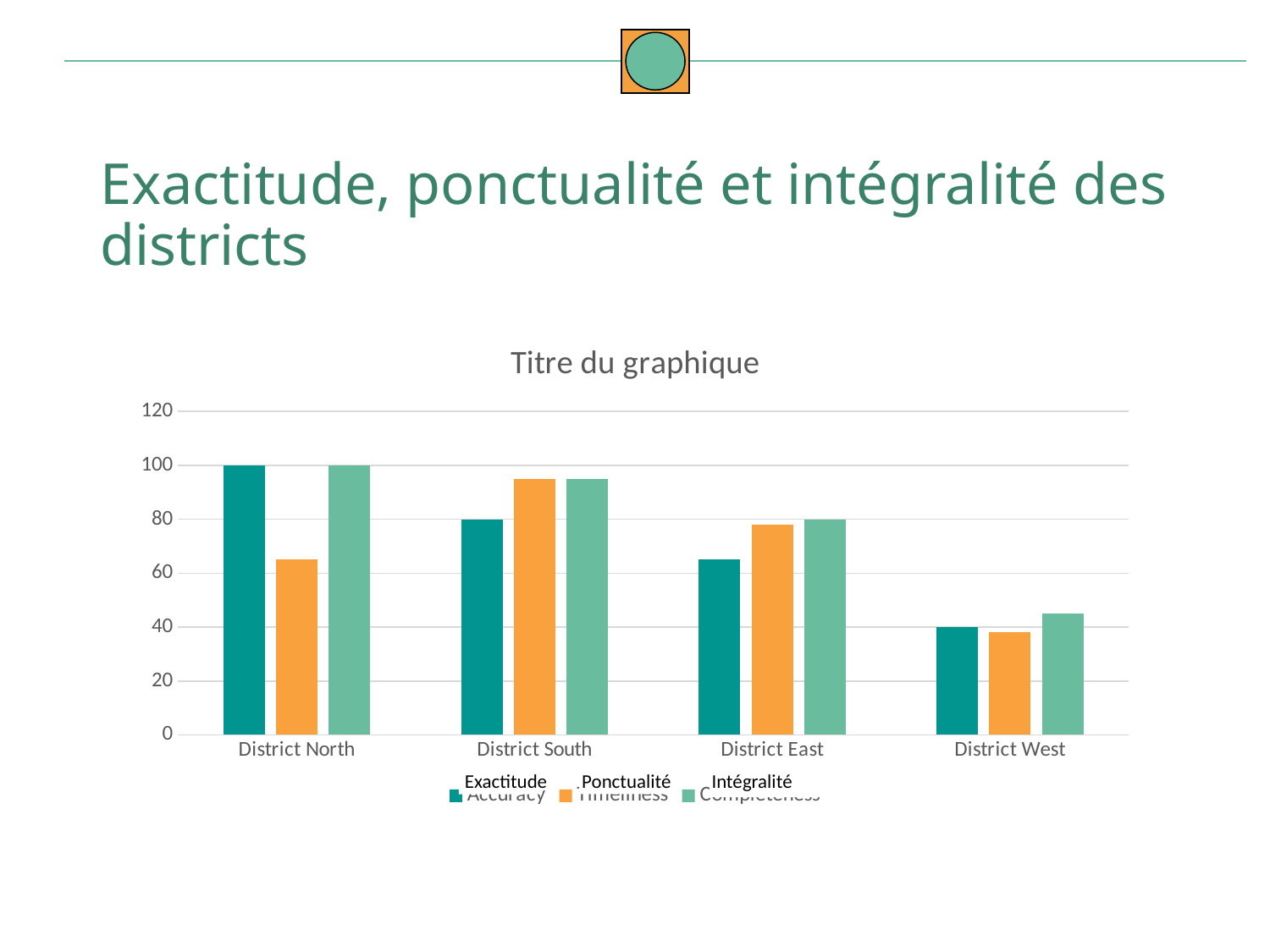
What is the Exactitude value for District West? 40 Is the Ponctualité value for District North greater or less than 80? less What is the Exactitude value for District South? 80 What type of chart is shown on the slide? bar chart How many series does the chart's legend list? 3 What is the title shown above the chart? Titre du graphique How many districts are shown on the x axis of the chart? 4 Is the Ponctualité value for District South greater or less than 80? greater What is the Intégralité value for District East? 80 What is the Exactitude value for District North? 100 Which is larger, the Exactitude value for District North or for District East? District North Which district has the lowest Exactitude value? District West